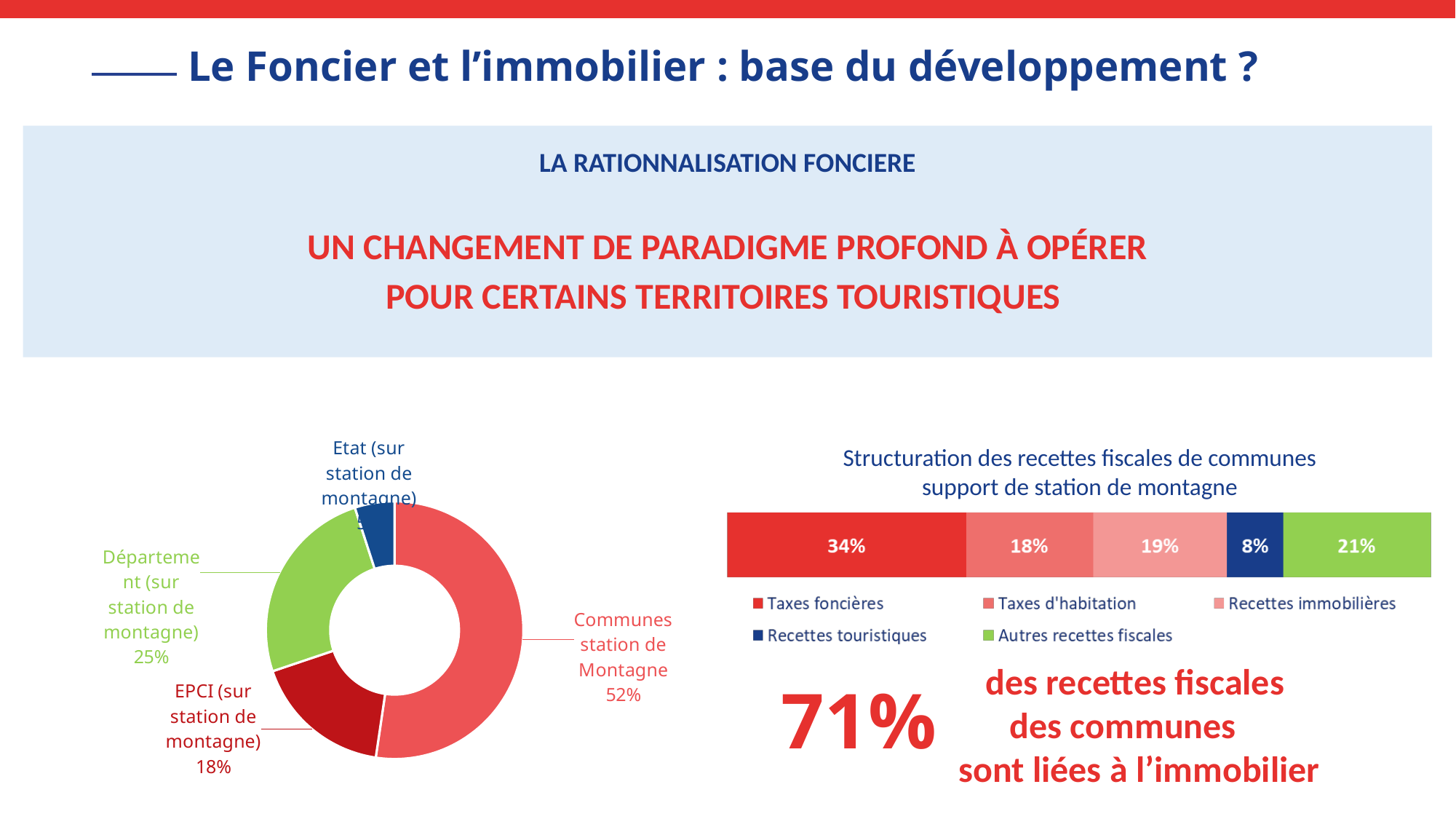
In the donut chart on the left, what is the difference between the shares of Communes station de Montagne and Département (sur station de montagne)? 27% In the donut chart on the left, which is larger: Département (sur station de montagne) or EPCI (sur station de montagne)? Département (sur station de montagne) In the donut chart on the left, what share is shown for Département (sur station de montagne)? 25% In the chart titled 'Structuration des recettes fiscales de communes support de station de montagne', what is the difference between Taxes foncières and Autres recettes fiscales? 13% In the donut chart on the left, which category has the largest share? Communes station de Montagne In the donut chart on the left, what share is shown for Communes station de Montagne? 52% In the chart titled 'Structuration des recettes fiscales de communes support de station de montagne', which series has the smallest percentage? Recettes touristiques What kind of chart is the one on the right of the slide, titled 'Structuration des recettes fiscales de communes support de station de montagne'? Stacked bar chart In the chart titled 'Structuration des recettes fiscales de communes support de station de montagne', what percentage is shown for Recettes touristiques? 8% In the donut chart on the left, what share is shown for EPCI (sur station de montagne)? 18% In the chart titled 'Structuration des recettes fiscales de communes support de station de montagne', how many series does the legend list? 5 In the chart titled 'Structuration des recettes fiscales de communes support de station de montagne', what percentage is shown for Taxes foncières? 34%